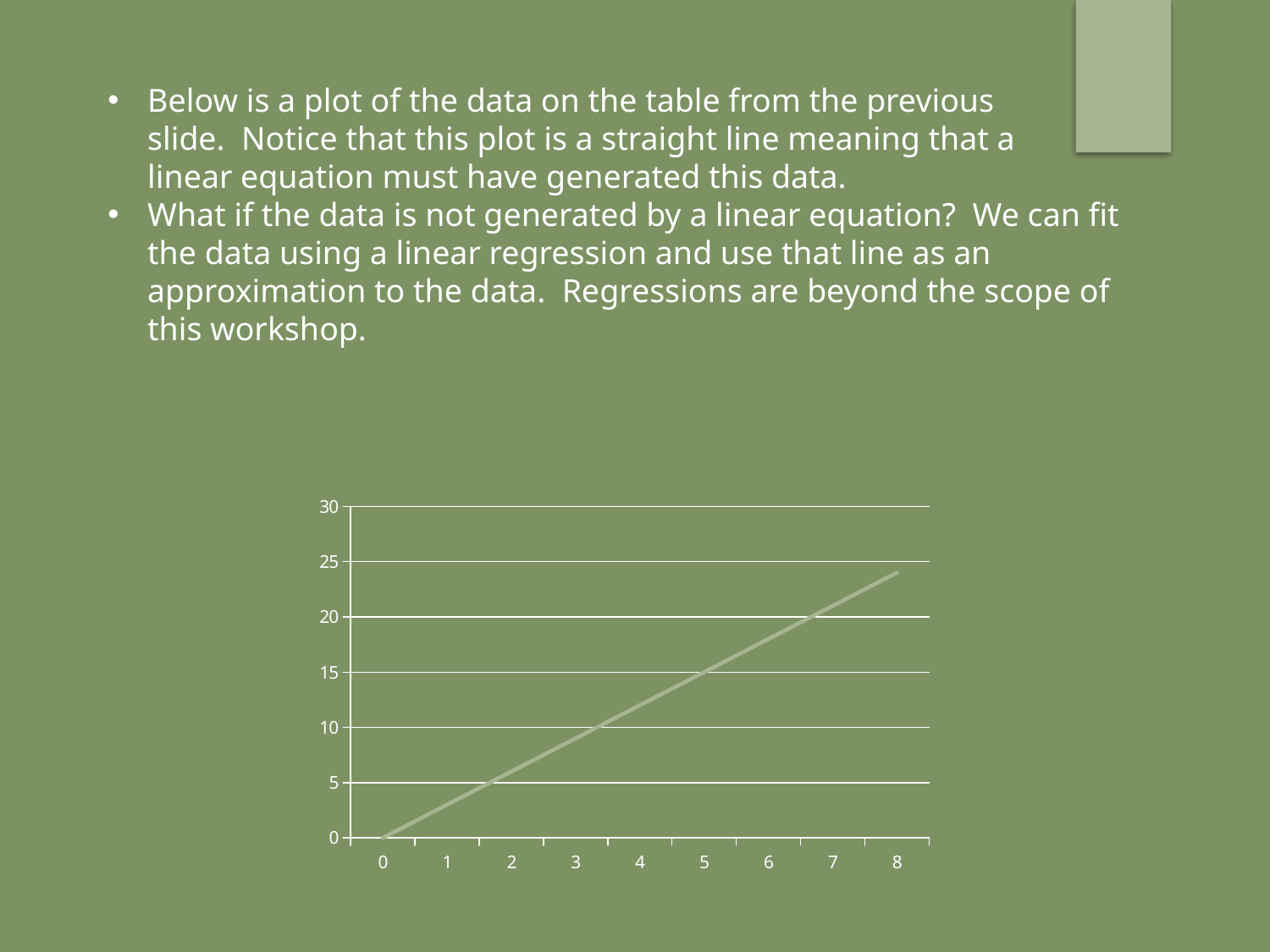
Is the value of the line at x = 6 greater or less than 20? less At which x value is the plotted line lowest? 0 What is the value of the line at x = 0? 0 What is the highest value labelled on the y axis? 30 Is the value of the line at x = 8 greater or less than 25? less Is the value of the line at x = 8 greater or less than 20? greater What kind of chart is shown on the slide? line chart At which x value is the plotted line highest? 8 Which is larger, the value of the line at x = 2 or at x = 6? x = 6 How many x-axis tick labels are shown on the chart? 9 Do the values rise or fall as x increases from 0 to 8? rise